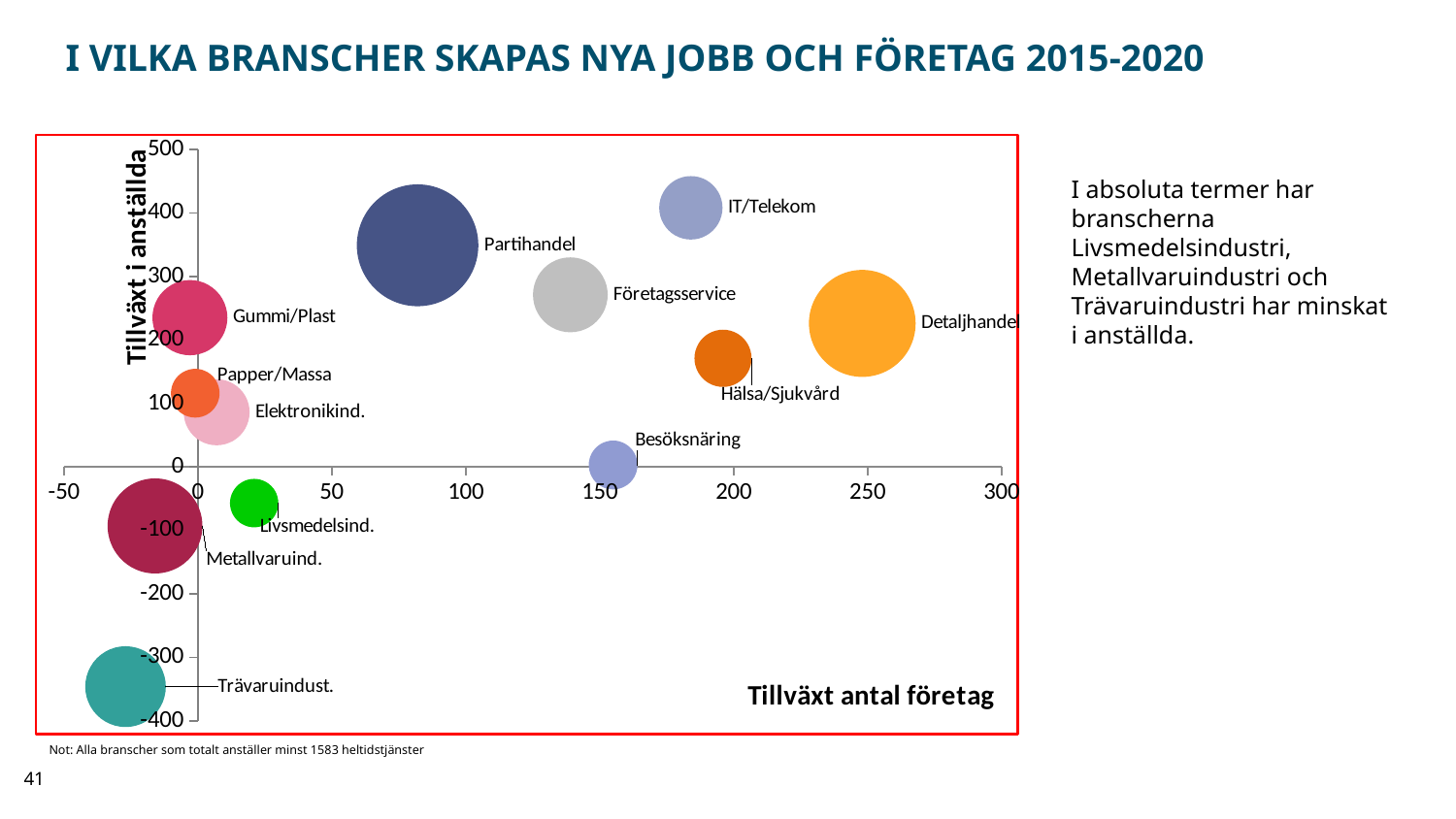
Is the growth in number of companies for Gummi/Plast greater or less than 50? less How many industries (bubbles) are plotted in the chart? 12 What kind of chart is shown on the slide? bubble chart What is the title of the vertical axis of the chart? Tillväxt i anställda Which industry has the highest growth in employees (Tillväxt i anställda)? IT/Telekom Is the growth in employees for Partihandel greater or less than 300? greater Which has higher growth in number of companies, Detaljhandel or Hälsa/Sjukvård? Detaljhandel Which has higher growth in employees, Partihandel or Företagsservice? Partihandel Which industry has the highest growth in number of companies (Tillväxt antal företag)? Detaljhandel Is the growth in number of companies for Detaljhandel greater or less than 200? greater Which industry has the lowest growth in employees (Tillväxt i anställda)? Trävaruindust.